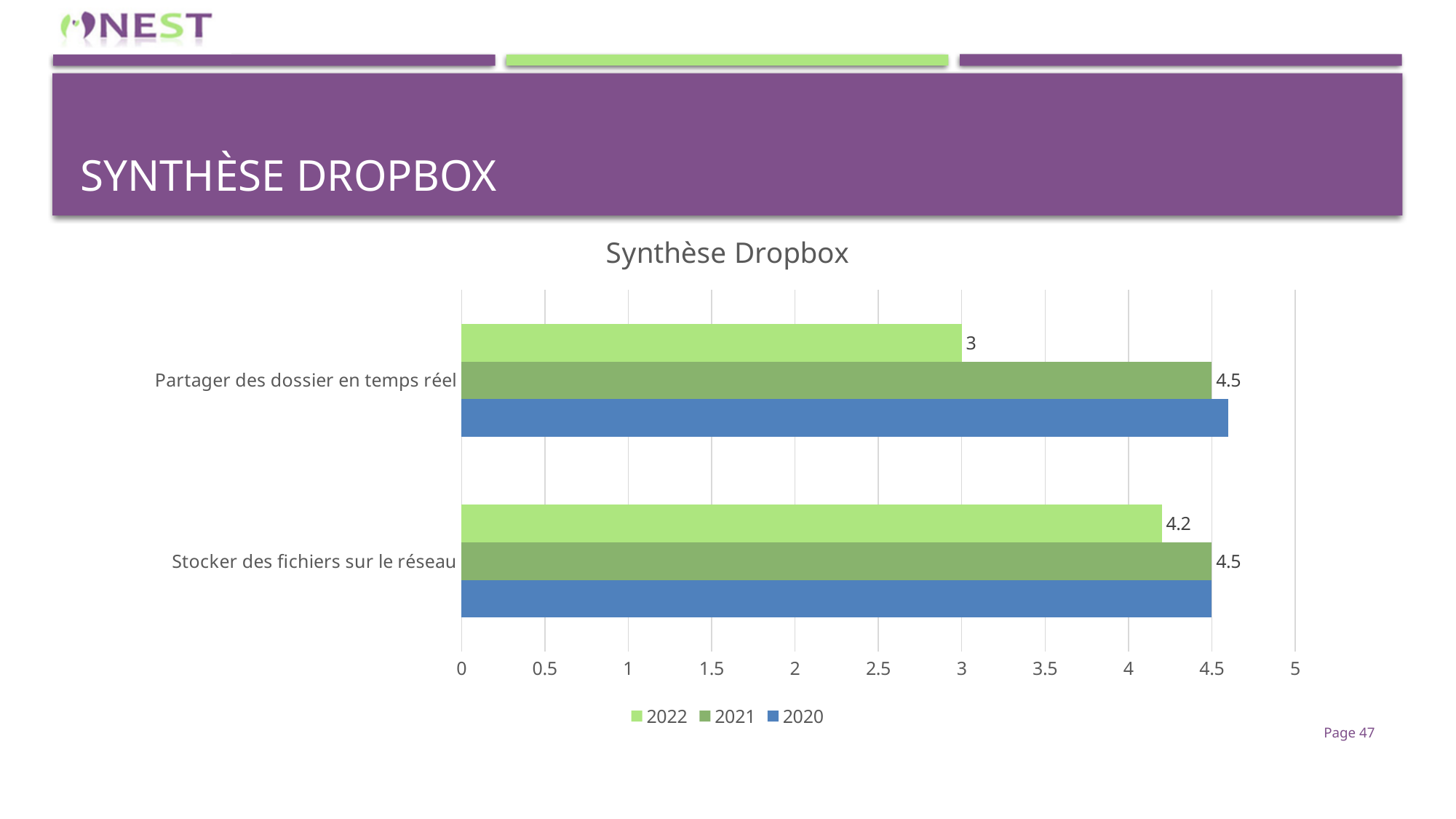
Is the 2020 value for "Stocker des fichiers sur le réseau" greater or less than 4? greater For the 2022 series, which category has the larger value: "Partager des dossier en temps réel" or "Stocker des fichiers sur le réseau"? Stocker des fichiers sur le réseau Is the 2020 value for "Partager des dossier en temps réel" greater or less than 4? greater What is the difference between the 2022 values for "Stocker des fichiers sur le réseau" and "Partager des dossier en temps réel"? 1.2 What is the value for 2021 for "Partager des dossier en temps réel"? 4.5 What is the value for 2022 for "Stocker des fichiers sur le réseau"? 4.2 What is the difference between the 2021 and 2022 values for "Partager des dossier en temps réel"? 1.5 How many categories are shown on the chart? 2 What is the value for 2022 for "Partager des dossier en temps réel"? 3 What is the value for 2021 for "Stocker des fichiers sur le réseau"? 4.5 Which category has the lowest value in the 2022 series? Partager des dossier en temps réel How many series does the legend list? 3